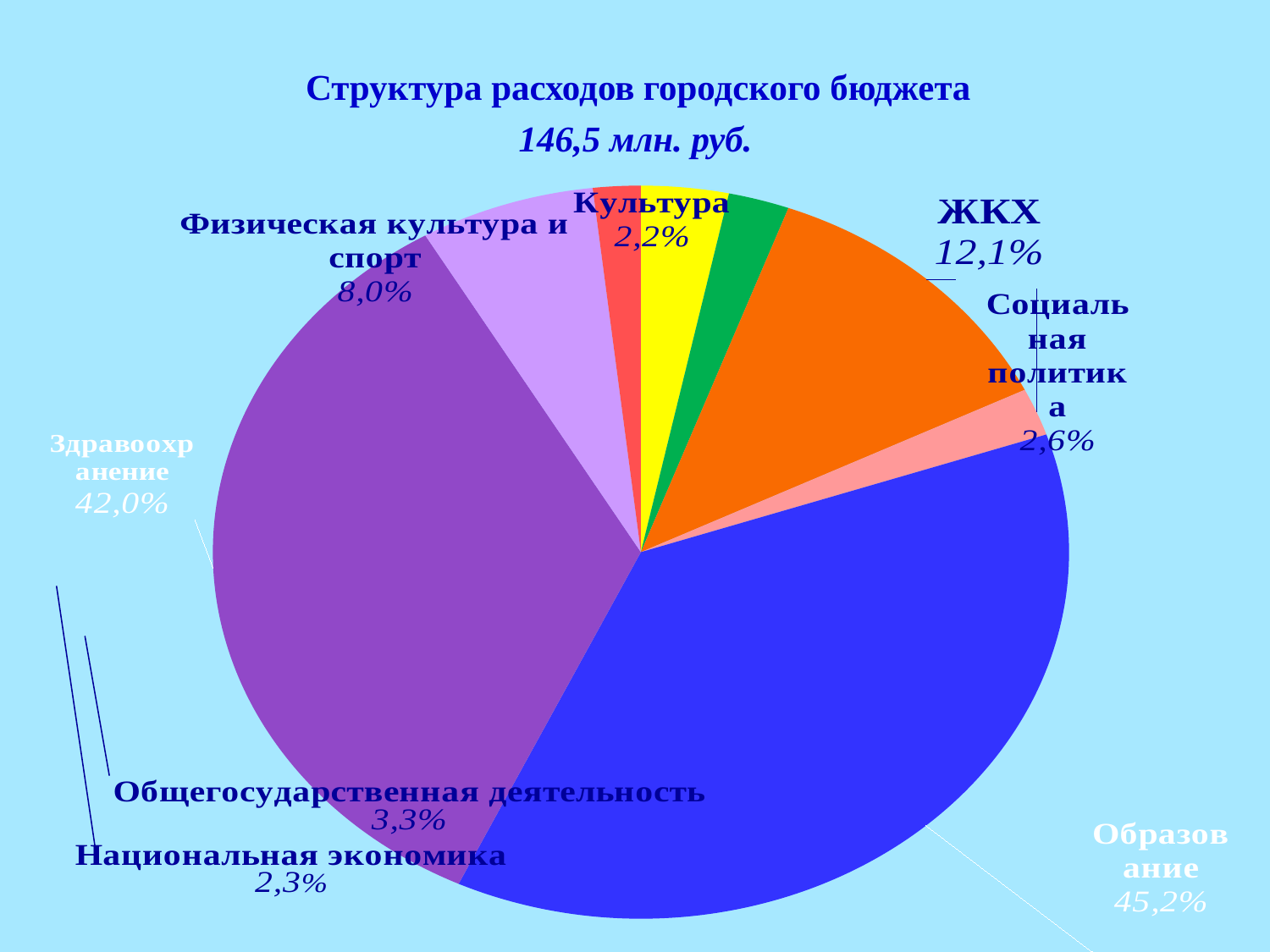
What is the title of the chart? Структура расходов городского бюджета What total budget amount is shown under the chart title? 146,5 млн. руб. What is the value for ЖКХ? 12,1% What kind of chart is shown on the slide? pie chart Which category has the largest share of the budget? Образование What is the value for Общегосударственная деятельность? 3,3% What share of the budget goes to Образование? 45,2% What is the value for Физическая культура и спорт? 8,0% How many categories are shown in the pie chart? 8 What is the difference in percentage points between Образование and Здравоохранение? 3,2 Which category has the smallest share of the budget? Культура What share of the budget goes to Здравоохранение? 42,0%